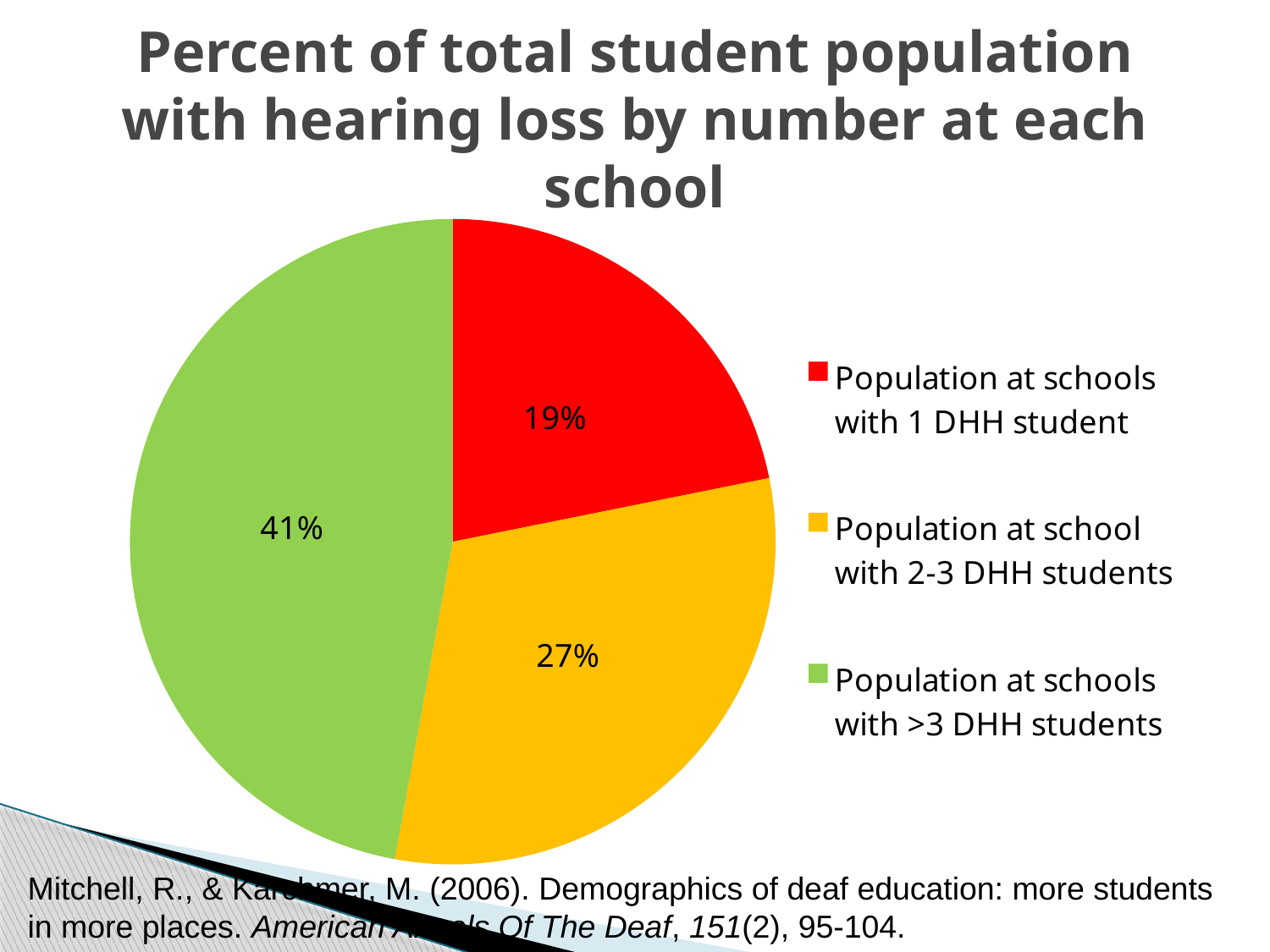
What percentage of the student population is at schools with >3 DHH students? 41% What is the difference in percentage points between the share at schools with >3 DHH students and the share at schools with 1 DHH student? 22 Which category has the smallest share of the pie? Population at schools with 1 DHH student What kind of chart is shown on the slide? Pie chart How many slices does the pie chart have? 3 What is the title of the chart? Percent of total student population with hearing loss by number at each school What colour is the slice for population at schools with >3 DHH students? Green Which is larger: the share at schools with 2-3 DHH students or the share at schools with 1 DHH student? Population at school with 2-3 DHH students What percentage of the student population is at schools with 1 DHH student? 19% What percentage of the student population is at schools with 2-3 DHH students? 27% What is the difference in percentage points between the share at schools with 2-3 DHH students and the share at schools with 1 DHH student? 8 Which category has the largest share of the pie? Population at schools with >3 DHH students